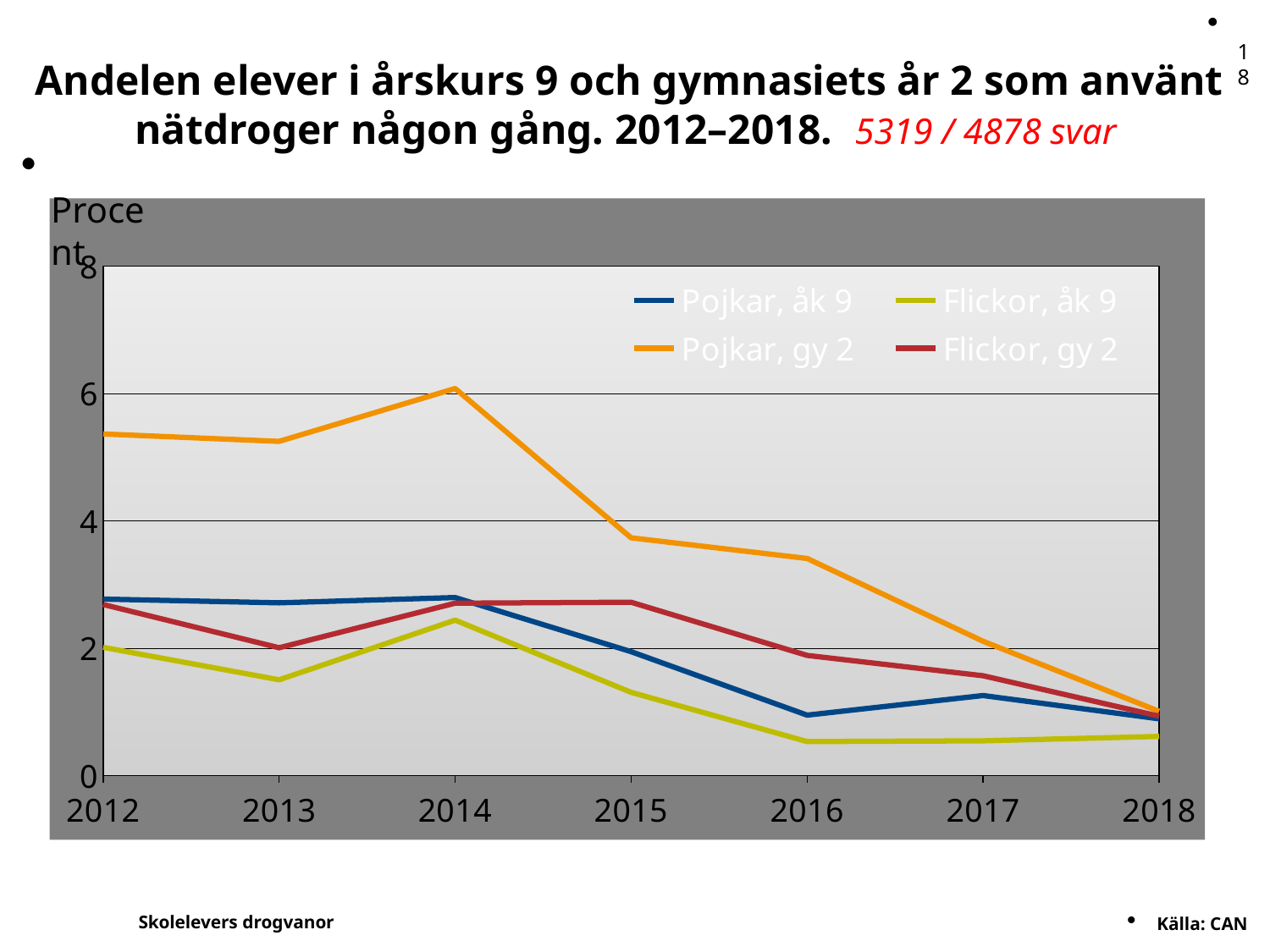
Is the value for Pojkar, gy 2 in 2012 greater or less than 4? greater Which series has the lowest value in 2017? Flickor, åk 9 How many years are shown on the x axis? 7 Is the value for Flickor, åk 9 in 2016 greater or less than 1? less In which year does the Pojkar, gy 2 series reach its highest value? 2014 What kind of chart is shown on the slide? line chart Which series has the highest value in 2014? Pojkar, gy 2 How many series does the legend list? 4 Is the value for Pojkar, åk 9 in 2013 greater or less than 2? greater In 2012, which is larger: the value for Pojkar, gy 2 or the value for Flickor, åk 9? Pojkar, gy 2 What colour is the line for Pojkar, gy 2? orange Does the Pojkar, gy 2 series rise or fall from 2014 to 2018? fall